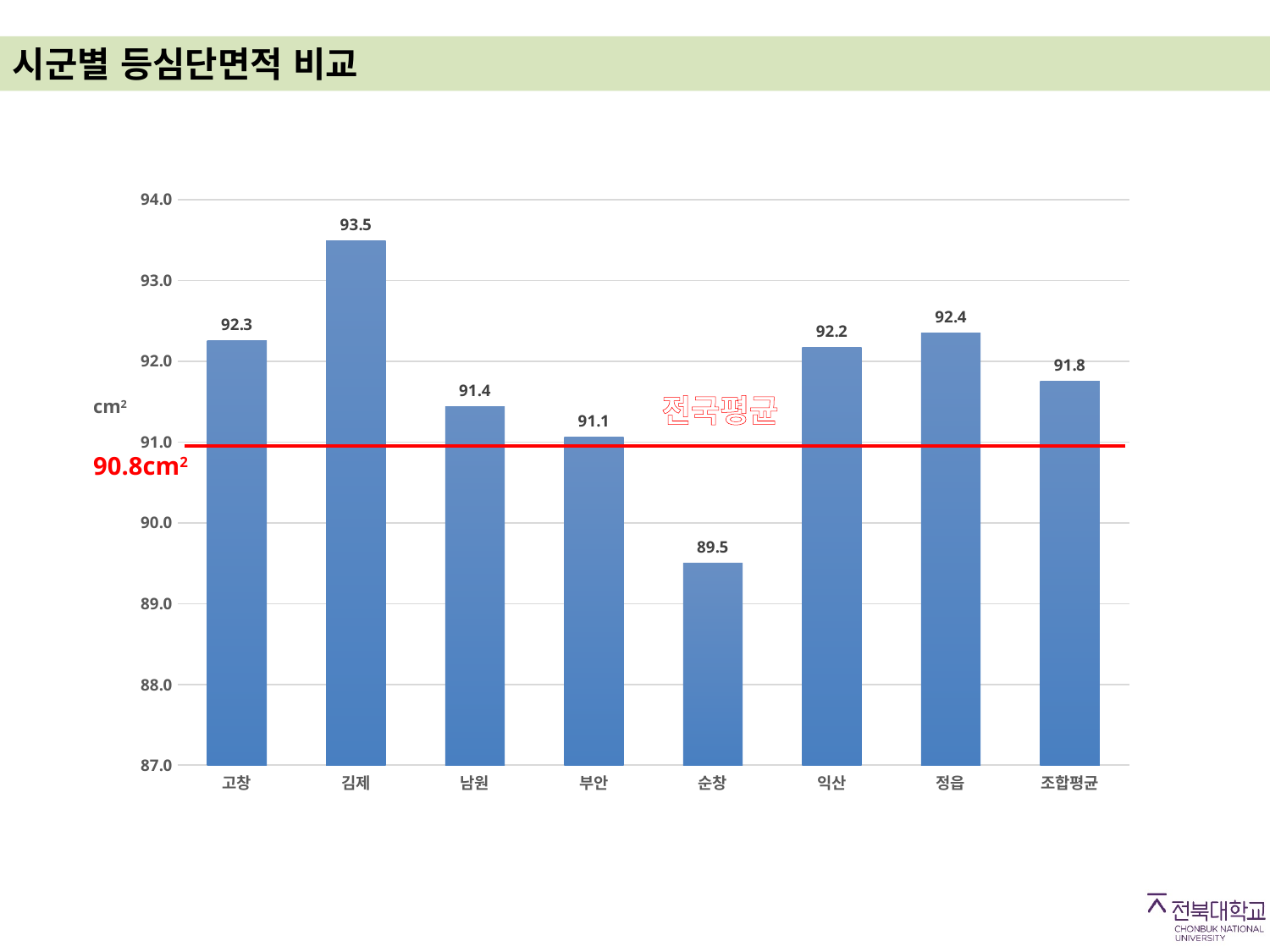
What is the difference between the values for 고창 and 남원? 0.9 What is the value for 조합평균? 91.8 Which category has the lowest value? 순창 What kind of chart is shown on the slide? bar chart What value is given for the red 전국평균 line? 90.8cm² What is the value for 김제? 93.5 How many categories are shown on the x axis? 8 Is the value for 순창 greater or less than 90.0? less Which is larger, the value for 정읍 or the value for 부안? 정읍 What is the difference between the values for 김제 and 순창? 4.0 What is the value for 순창? 89.5 Which category has the highest value? 김제